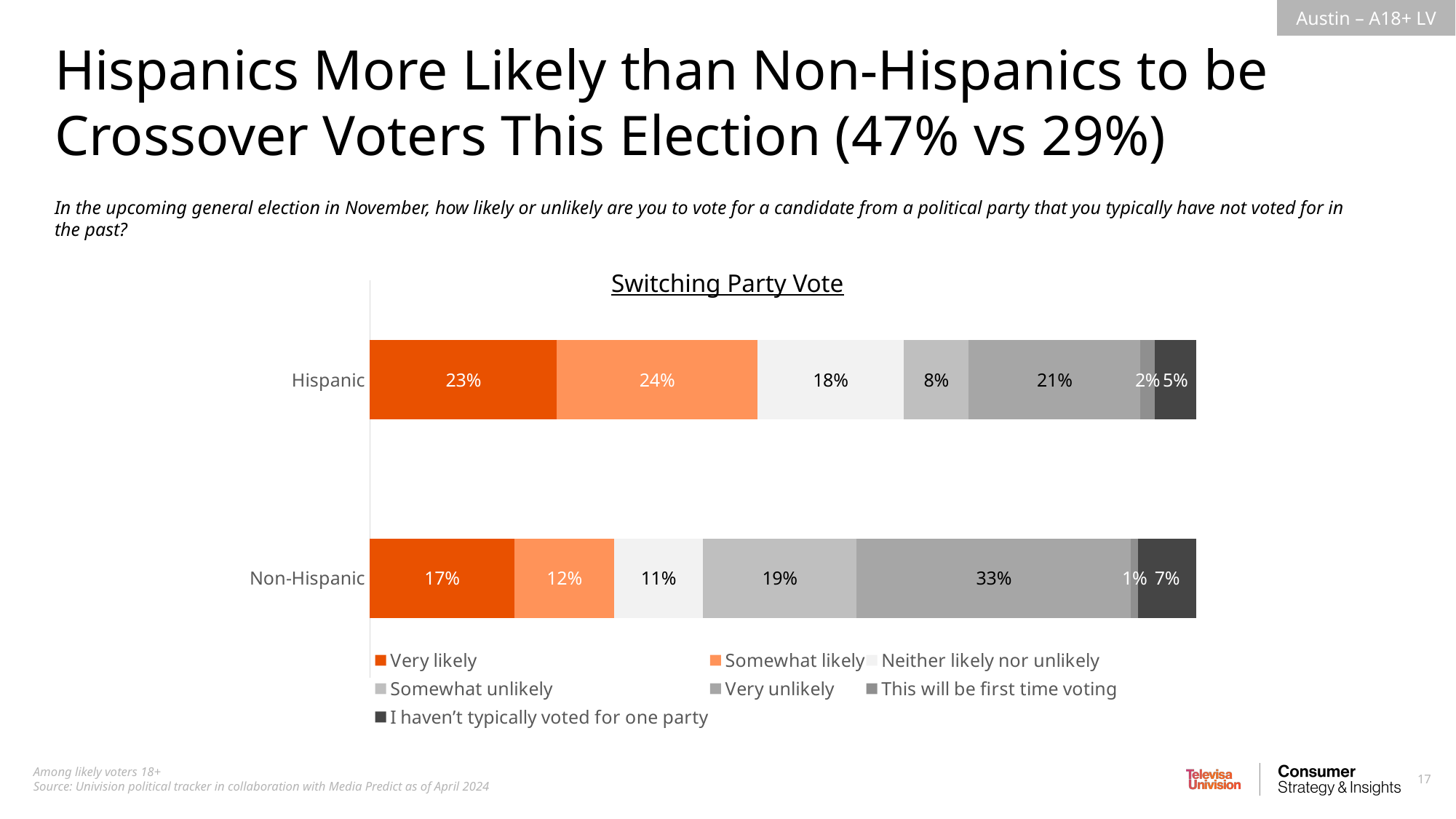
Which segment is the largest in the Non-Hispanic bar? Very unlikely What type of chart is shown on the slide? Stacked bar chart What is the difference between the 'Very unlikely' values for Non-Hispanic and Hispanic? 12% What is the 'Very unlikely' value for Non-Hispanic? 33% What is the 'Very likely' value for Hispanic? 23% How many series does the chart legend list? 7 How many categories (bars) are shown in the chart? 2 What is the 'Somewhat likely' value for Non-Hispanic? 12% What is the 'This will be first time voting' value for Hispanic? 2% What is the combined 'Very likely' and 'Somewhat likely' value for Hispanic? 47% Which group has the larger 'Very likely' value, Hispanic or Non-Hispanic? Hispanic What is the title of the chart? Switching Party Vote